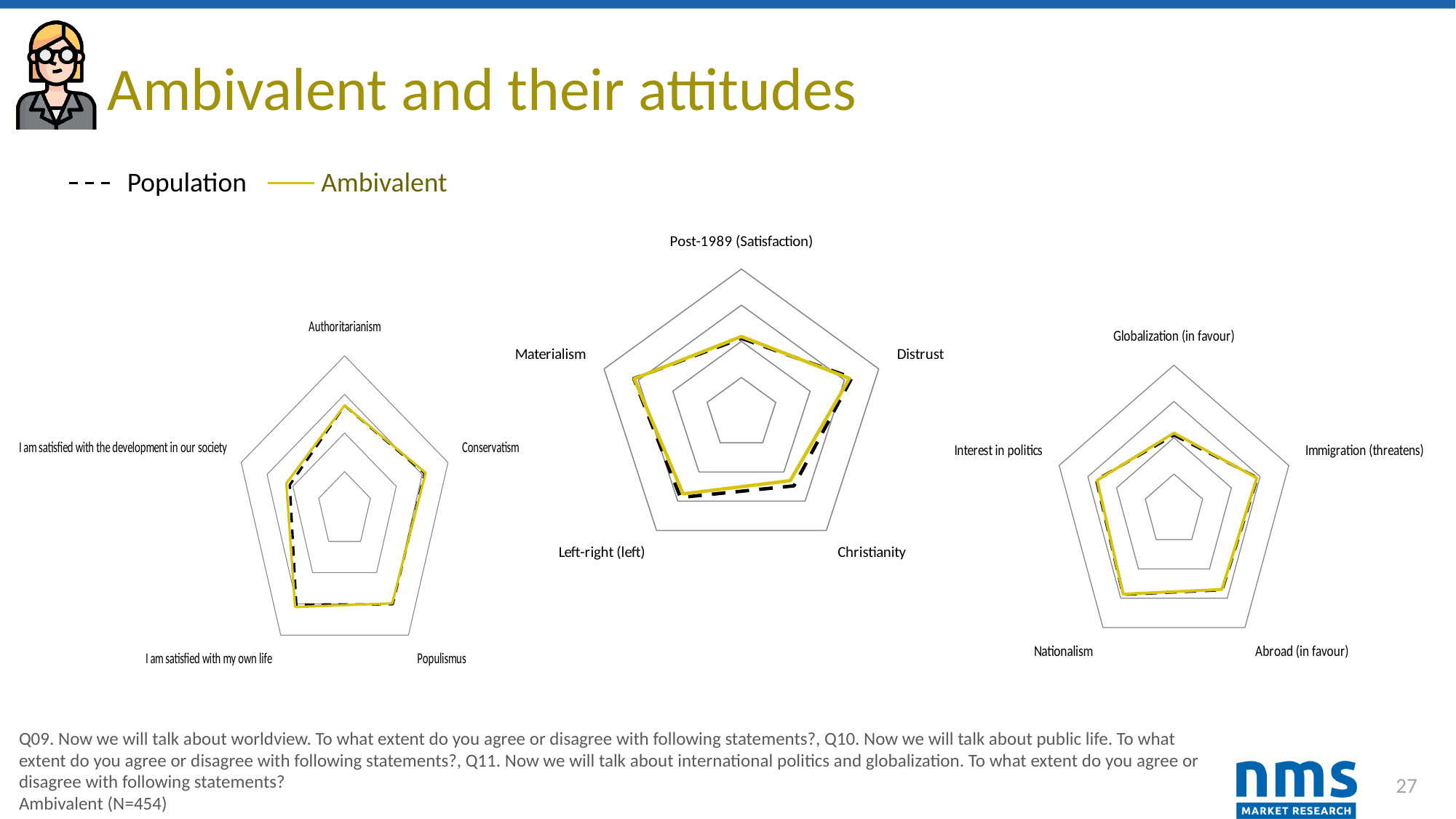
In the left chart, is the Ambivalent value for Populismus larger or smaller than for Authoritarianism? Larger In the right chart, which axis has the lowest value for the Ambivalent series? Globalization (in favour) What colour is the line for the Ambivalent series? Yellow How many series does the legend list? 2 In the middle chart (Post-1989 (Satisfaction) / Distrust / Christianity), how many axes (categories) are there? 5 How many charts are shown on the slide? 3 In the middle chart, is the Ambivalent value for Materialism larger or smaller than for Post-1989 (Satisfaction)? Larger In the right chart (Globalization (in favour) / Immigration (threatens) / Nationalism), how many axes (categories) are there? 5 In the right chart, is the Ambivalent value for Nationalism larger or smaller than for Globalization (in favour)? Larger What kind of chart is used on this slide? Radar chart Which series is drawn with a dashed line in the legend? Population